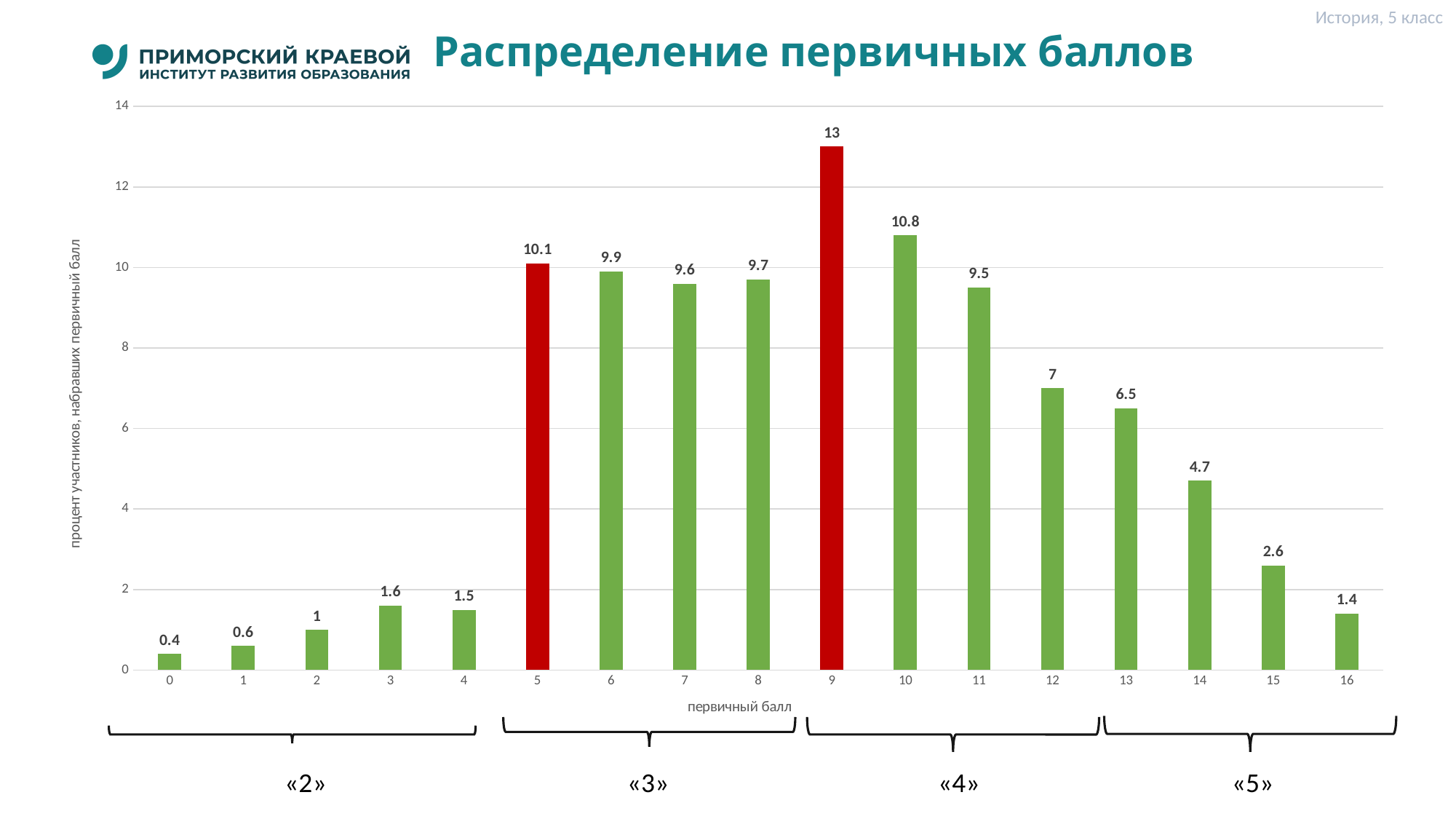
What kind of chart is shown on the slide? bar chart How many primary score categories are shown on the x axis? 17 What is the value shown for primary score 14? 4.7 Which primary score has the lowest percentage of participants? 0 What is the value shown for primary score 5? 10.1 Is the value for primary score 11 greater or less than 8? greater Which primary score has the highest percentage of participants? 9 What percentage of participants scored a primary score of 9? 13 Which primary scores are shown with red bars? 5 and 9 What is the difference between the values for primary scores 9 and 10? 2.2 Which has a larger value: primary score 12 or primary score 13? 12 Do the values rise or fall from primary score 10 to primary score 16? fall